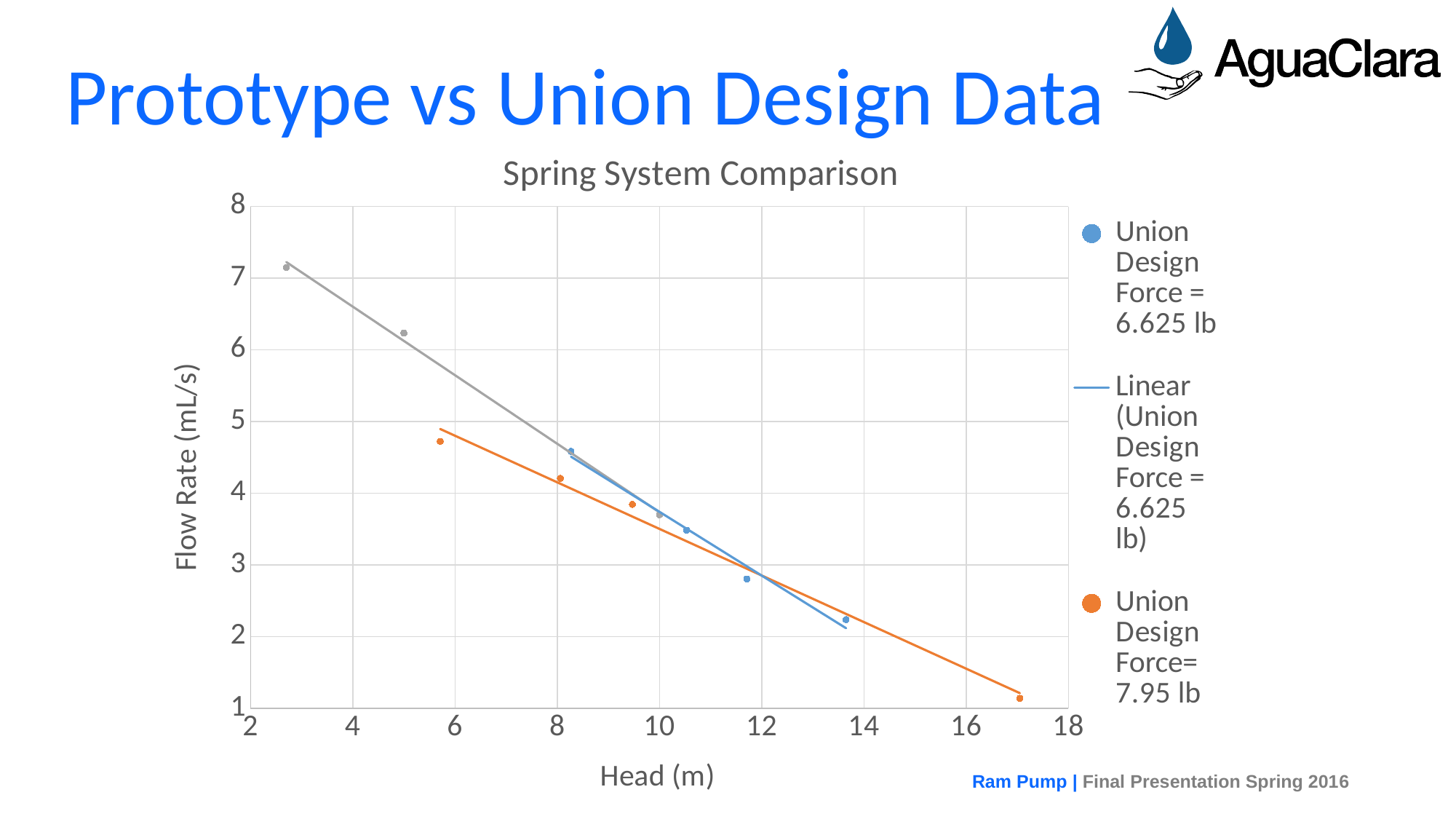
Is the flow rate of the leftmost orange point (head about 6 m) greater or less than 5 mL/s? less As head increases along the x axis, does the flow rate rise or fall? fall Is the flow rate of the rightmost blue point (head about 14 m) greater or less than 2 mL/s? greater How many orange data points are plotted for the Union Design Force= 7.95 lb series? 4 What is the label of the y axis? Flow Rate (mL/s) How many entries does the legend list? 3 Which series contains the point with the highest flow rate on the chart? the gray series Is the flow rate of the orange point at the far right (head about 17 m) greater or less than 2 mL/s? less What is the title of the chart? Spring System Comparison Near a head of 8 m, which series has the higher flow rate: the blue (6.625 lb) series or the orange (7.95 lb) series? blue (6.625 lb) What kind of chart is shown on the slide? scatter chart